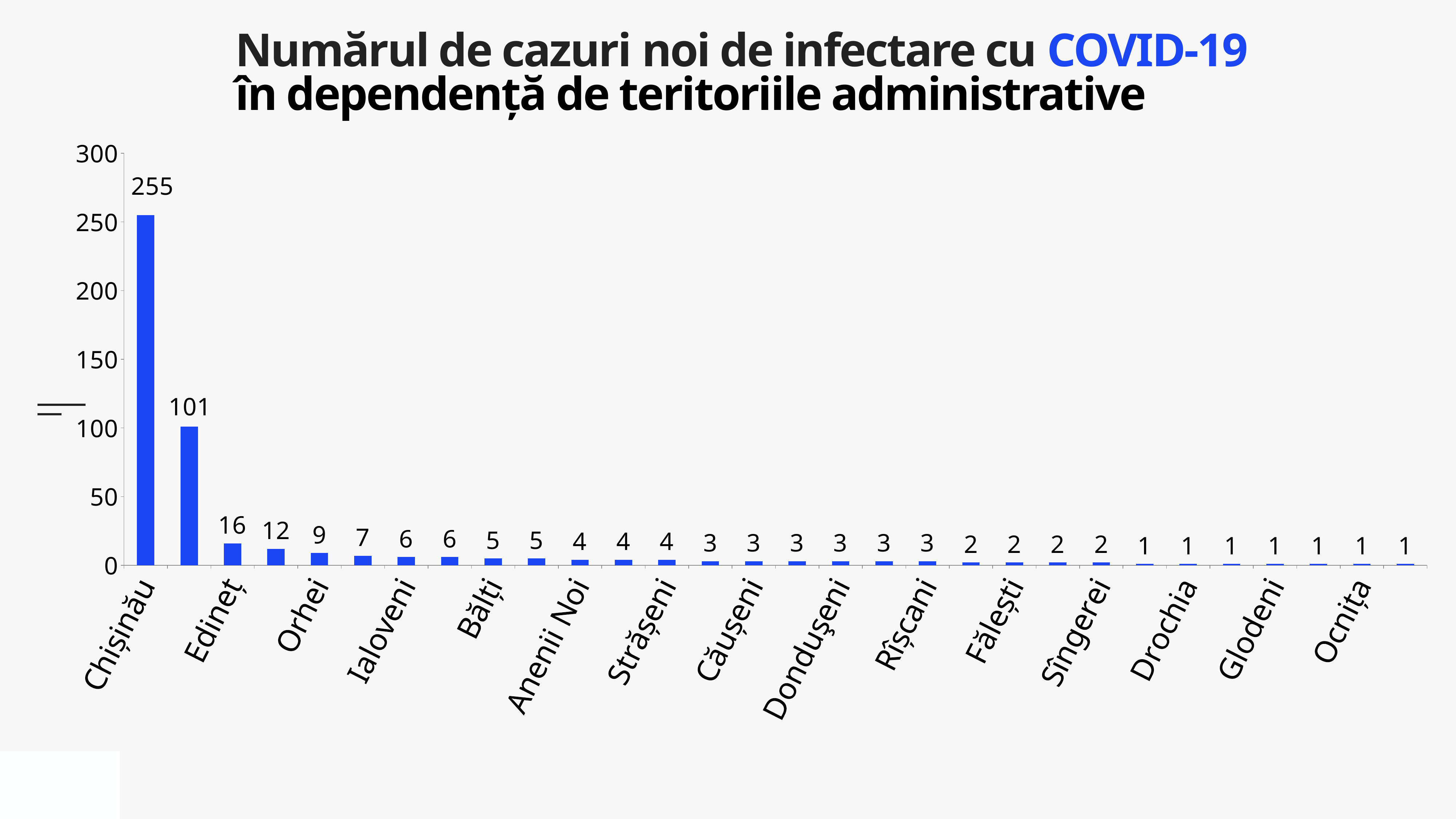
Is the value for Chișinău greater or less than 200? greater Do the values rise or fall from left to right along the x axis? fall What is the highest tick value shown on the vertical axis? 300 How many bars have a value of 1? 7 What is the difference between the two tallest bars (255 and 101)? 154 Which has more new cases, Chișinău or Edineț? Chișinău How many bars are plotted in the chart? 30 What is the number of new COVID-19 cases for Chișinău? 255 What is the smallest value shown on any bar in the chart? 1 What is the value of the second tallest bar in the chart? 101 Which administrative territory has the highest number of new cases? Chișinău What type of chart is shown on the slide? bar chart